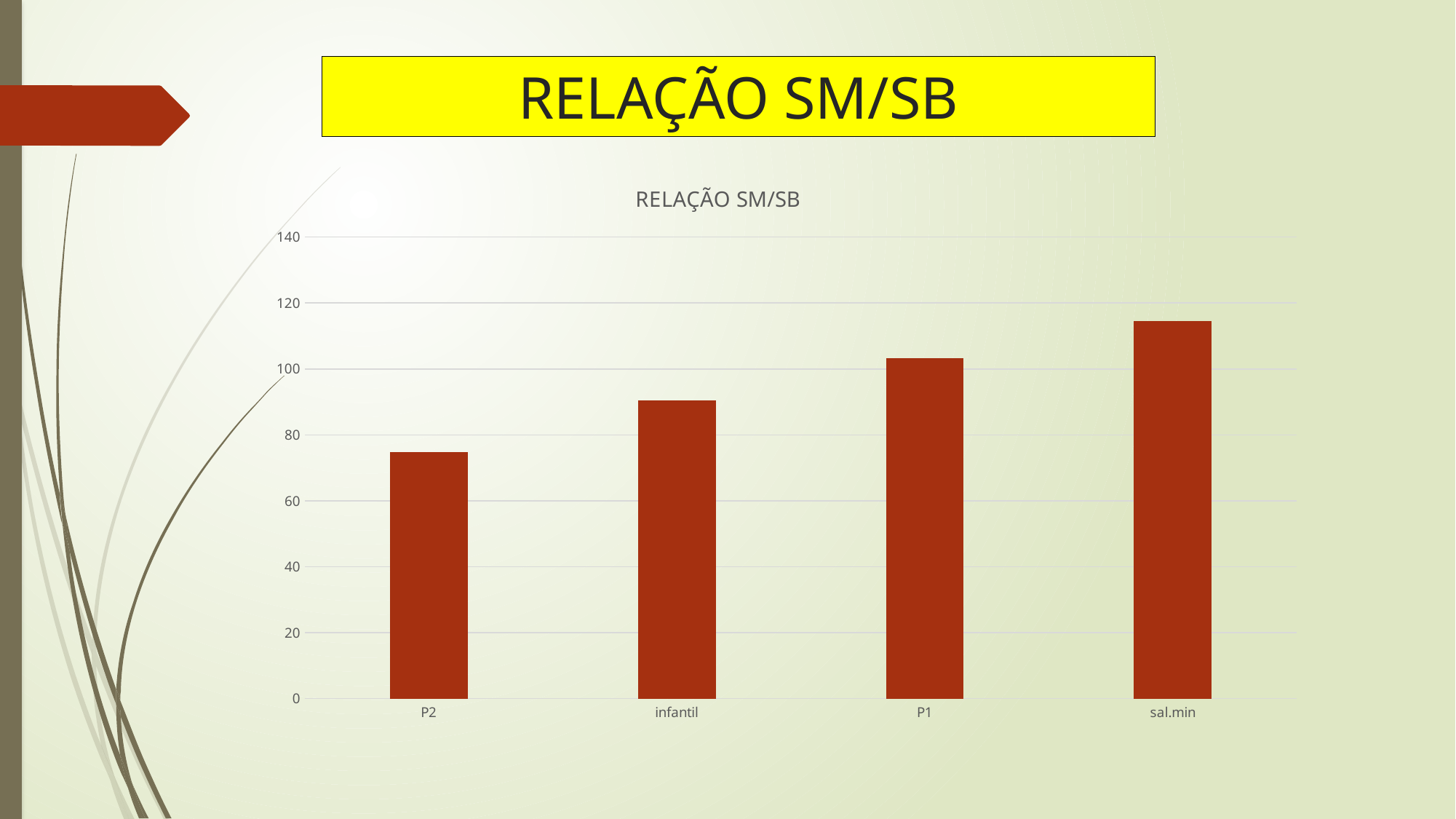
What is the title of the chart? RELAÇÃO SM/SB What kind of chart is shown on the slide? bar chart Which category has the lowest bar? P2 Is the value for infantil greater or less than 100? less Do the bar values rise or fall from left to right along the x axis? rise Is the value for P2 greater or less than 60? greater Is the value for infantil greater or less than 80? greater Which category has the highest bar? sal.min Which is larger, the value for P1 or the value for infantil? P1 How many categories are shown on the x axis of the chart? 4